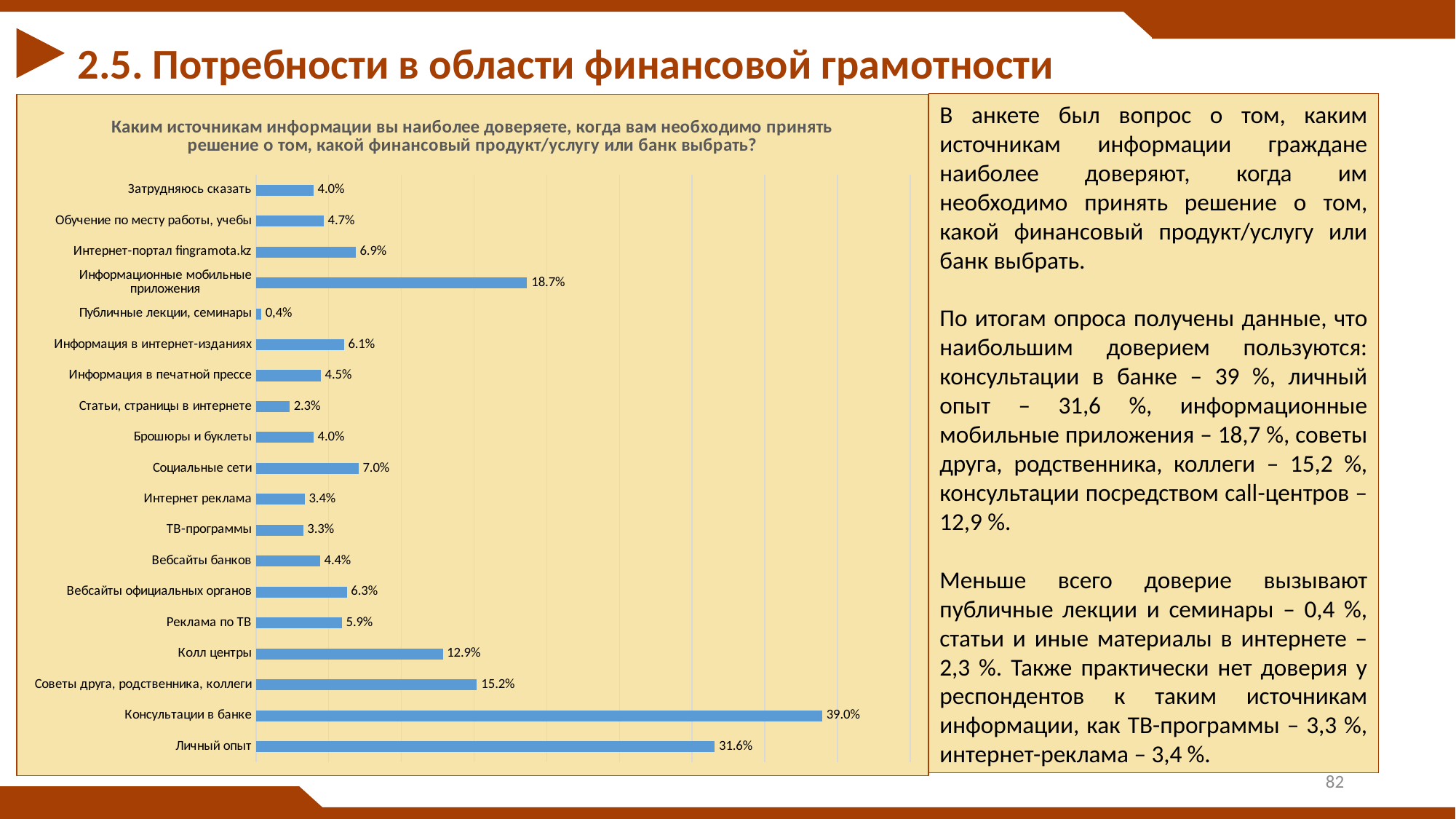
Which category has the lowest value? Публичные лекции, семинары Which is larger: "Интернет-портал fingramota.kz" or "Вебсайты официальных органов"? Интернет-портал fingramota.kz What is the value for "Информационные мобильные приложения"? 18.7% What is the difference between "Консультации в банке" and "Личный опыт"? 7.4% How many categories are shown in the chart? 19 What is the title of the chart? Каким источникам информации вы наиболее доверяете, когда вам необходимо принять решение о том, какой финансовый продукт/услугу или банк выбрать? Which category has the highest value? Консультации в банке What is the difference between "Советы друга, родственника, коллеги" and "Колл центры"? 2.3% What is the value for "Колл центры"? 12.9% What is the value for "Социальные сети"? 7.0% What type of chart is shown on the slide? Bar chart What is the value for "Консультации в банке"? 39.0%